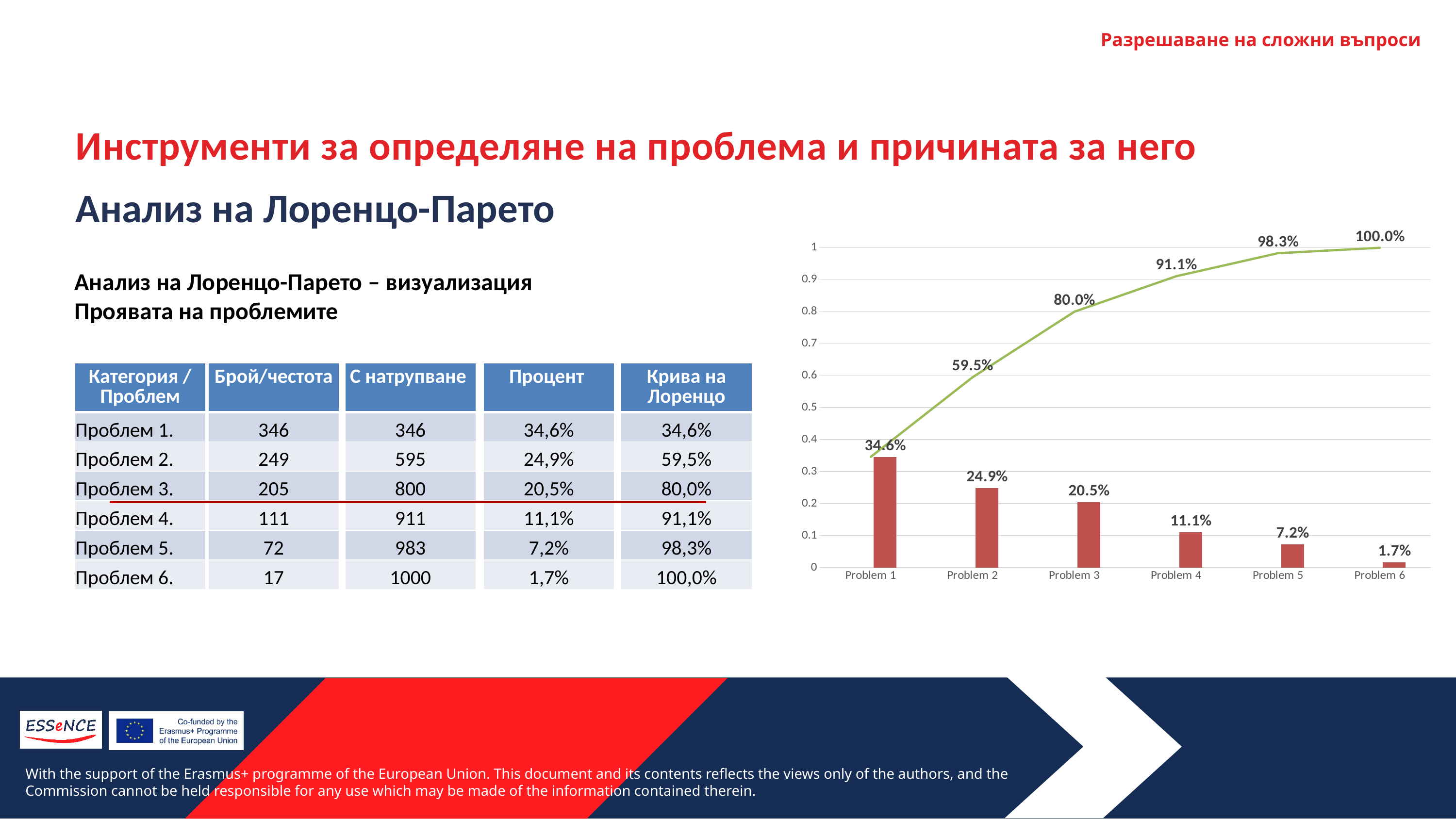
Do the bar values rise or fall from Problem 1 to Problem 6? fall What is the difference between the bar values for Problem 2 and Problem 3? 4.4% What kind of chart is shown on the slide? Combined bar and line chart Is the bar for Problem 2 greater or less than 0.2 on the axis? greater Which problem has the lowest bar? Problem 6 Which problem has the highest bar? Problem 1 What is the bar value for Problem 4? 11.1% Which has a larger bar value, Problem 4 or Problem 5? Problem 4 What is the bar value for Problem 1? 34.6% How many problem categories are shown on the x axis? 6 What is the cumulative line value at Problem 3? 80.0% What is the cumulative line value at Problem 5? 98.3%